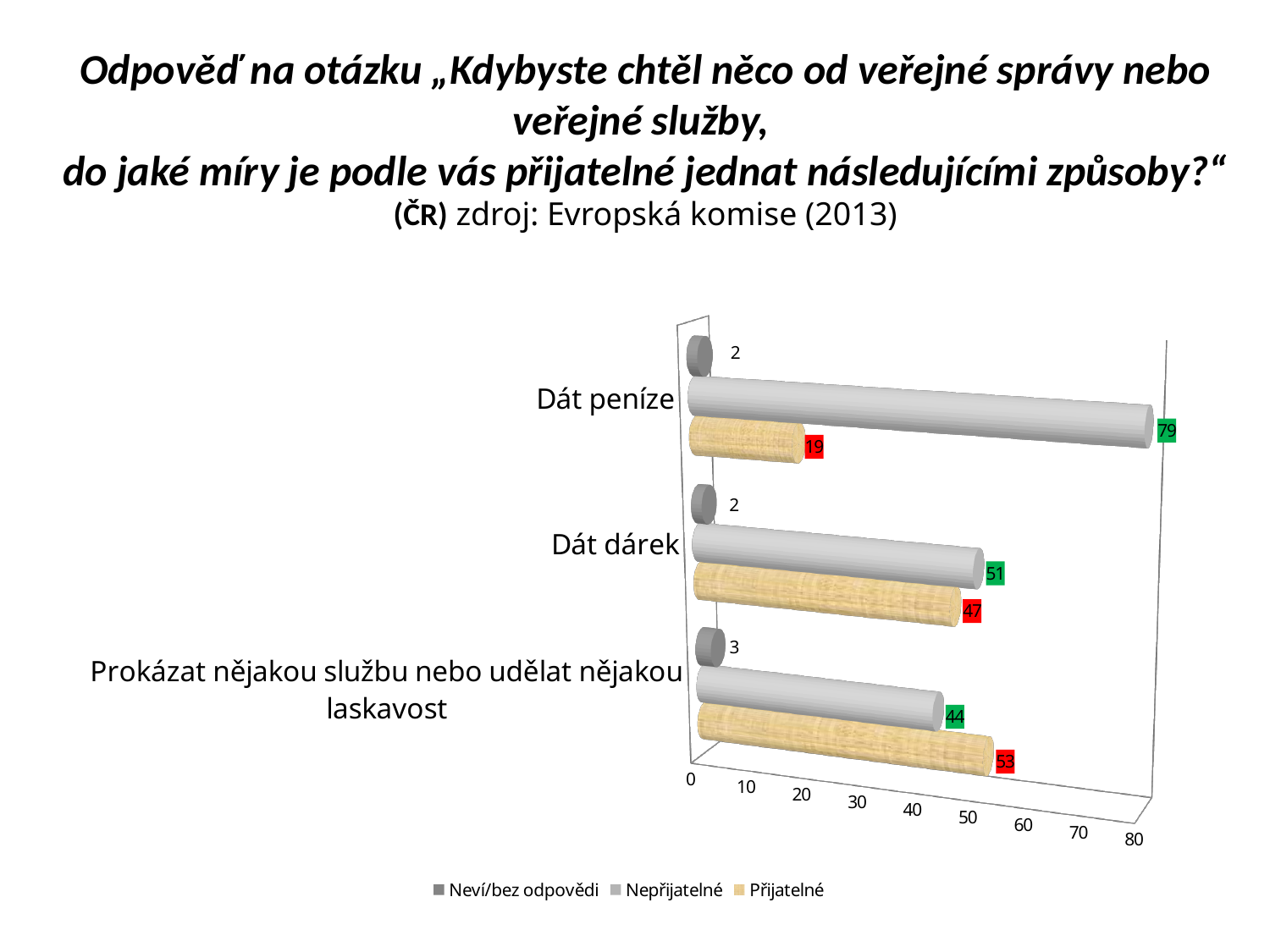
How many categories are shown on the chart? 3 What is the difference between the Nepřijatelné and Přijatelné values for Dát peníze? 60 What is the value of Nepřijatelné for Dát peníze? 79 What is the value of Přijatelné for Dát dárek? 47 What is the value of Neví/bez odpovědi for Prokázat nějakou službu nebo udělat nějakou laskavost? 3 What kind of chart is shown on the slide? Bar chart How many series does the legend list? 3 For Prokázat nějakou službu nebo udělat nějakou laskavost, which is larger: Nepřijatelné or Přijatelné? Přijatelné What is the value of Přijatelné for Dát peníze? 19 What is the total of the three values for Dát dárek? 100 Which category has the lowest Přijatelné value? Dát peníze Which category has the highest Nepřijatelné value? Dát peníze